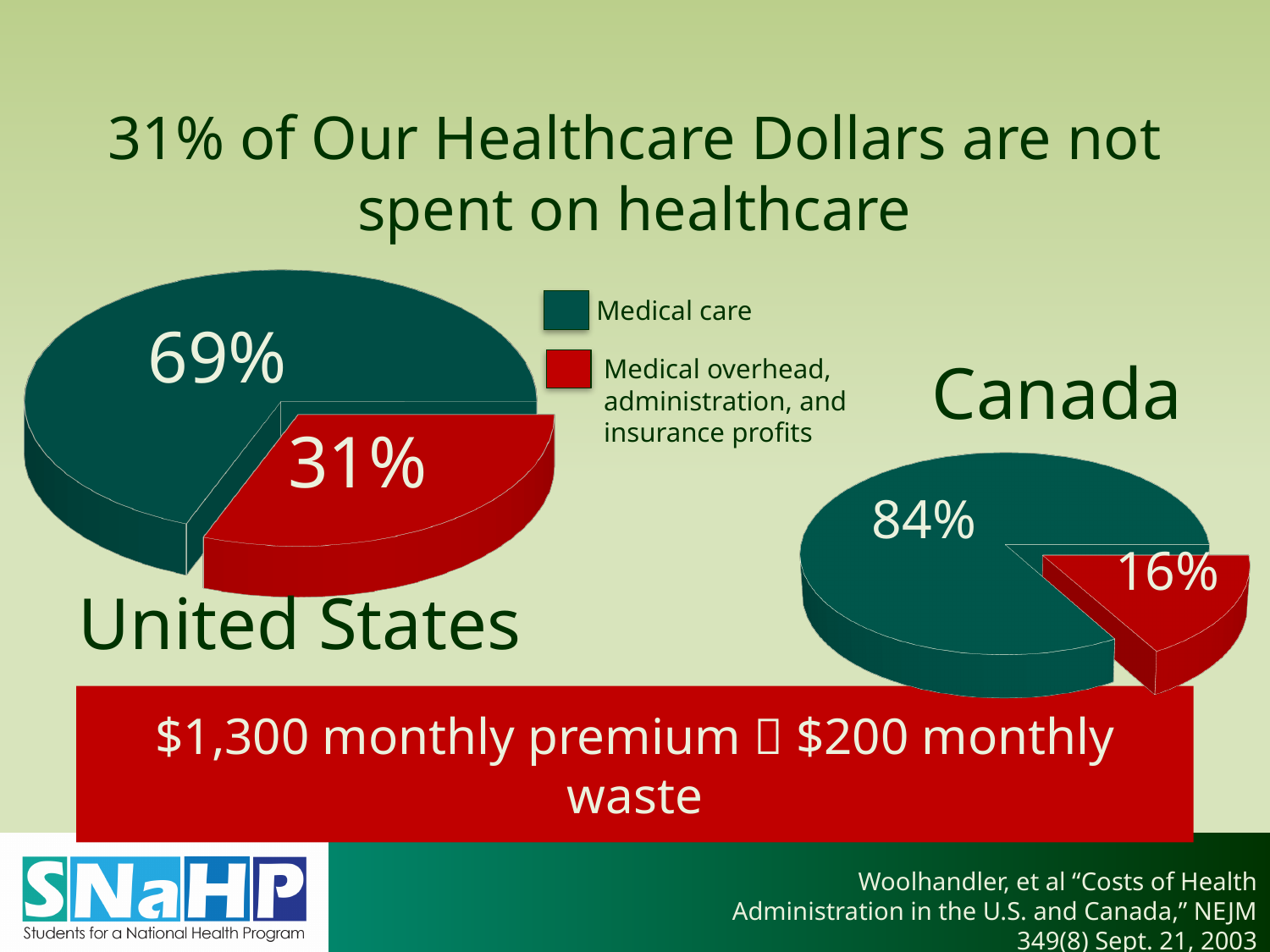
What colour represents Medical care in the pie charts? Dark green How many slices does the Canada pie chart have? 2 What kind of chart is used for the United States data? Pie chart In the United States pie chart, what share is labelled for Medical overhead, administration, and insurance profits? 31% Which pie chart shows a larger Medical care share, United States or Canada? Canada In the Canada pie chart, which slice is the smallest? Medical overhead, administration, and insurance profits In the United States pie chart, what share is labelled for Medical care? 69% In the Canada pie chart, what share is labelled for Medical care? 84% What is the difference between the Medical overhead share in the United States pie chart and in the Canada pie chart? 15% In the Canada pie chart, what share is labelled for Medical overhead, administration, and insurance profits? 16% How many entries does the legend list? 2 In the United States pie chart, which slice is the largest? Medical care